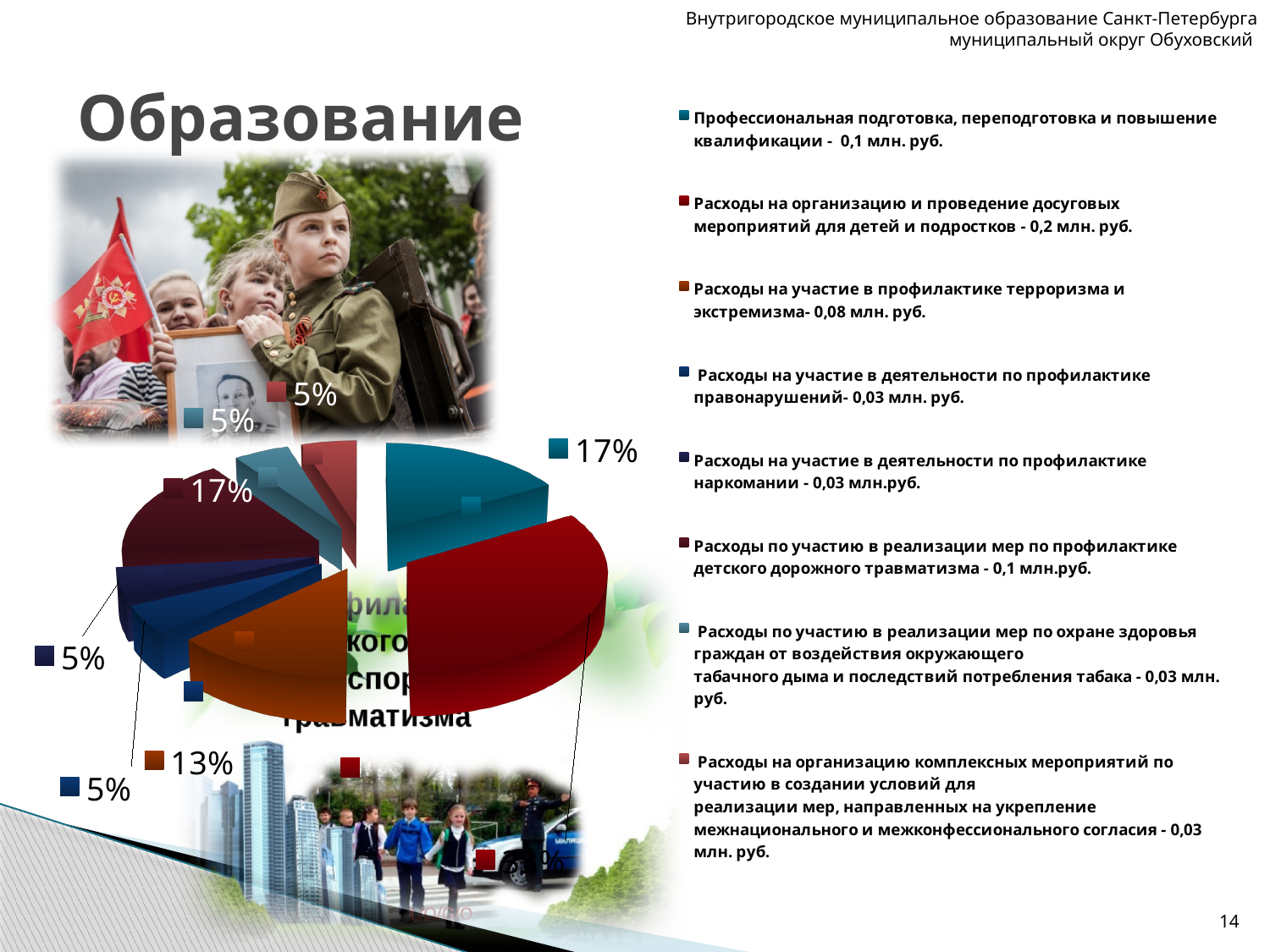
What is the difference between the slice labelled 17% and the slice labelled 13%? 4% How many slices of the pie chart are labelled 5%? 4 Which is larger: the slice labelled 13% or a slice labelled 5%? The slice labelled 13% How many expense items are listed in the legend to the right of the pie chart? 8 According to the legend, what is the amount for 'Расходы на участие в профилактике терроризма и экстремизма'? 0,08 млн. руб. What is the largest percentage label visible on the pie chart? 17% What kind of chart is shown on the slide? Pie chart Which expense item in the legend has the largest amount? Расходы на организацию и проведение досуговых мероприятий для детей и подростков What is the title of the slide containing the pie chart? Образование According to the legend, what is the amount for 'Расходы по участию в реализации мер по профилактике детского дорожного травматизма'? 0,1 млн.руб. According to the legend, what is the amount for 'Расходы на организацию и проведение досуговых мероприятий для детей и подростков'? 0,2 млн. руб. According to the legend, what is the amount for 'Профессиональная подготовка, переподготовка и повышение квалификации'? 0,1 млн. руб.